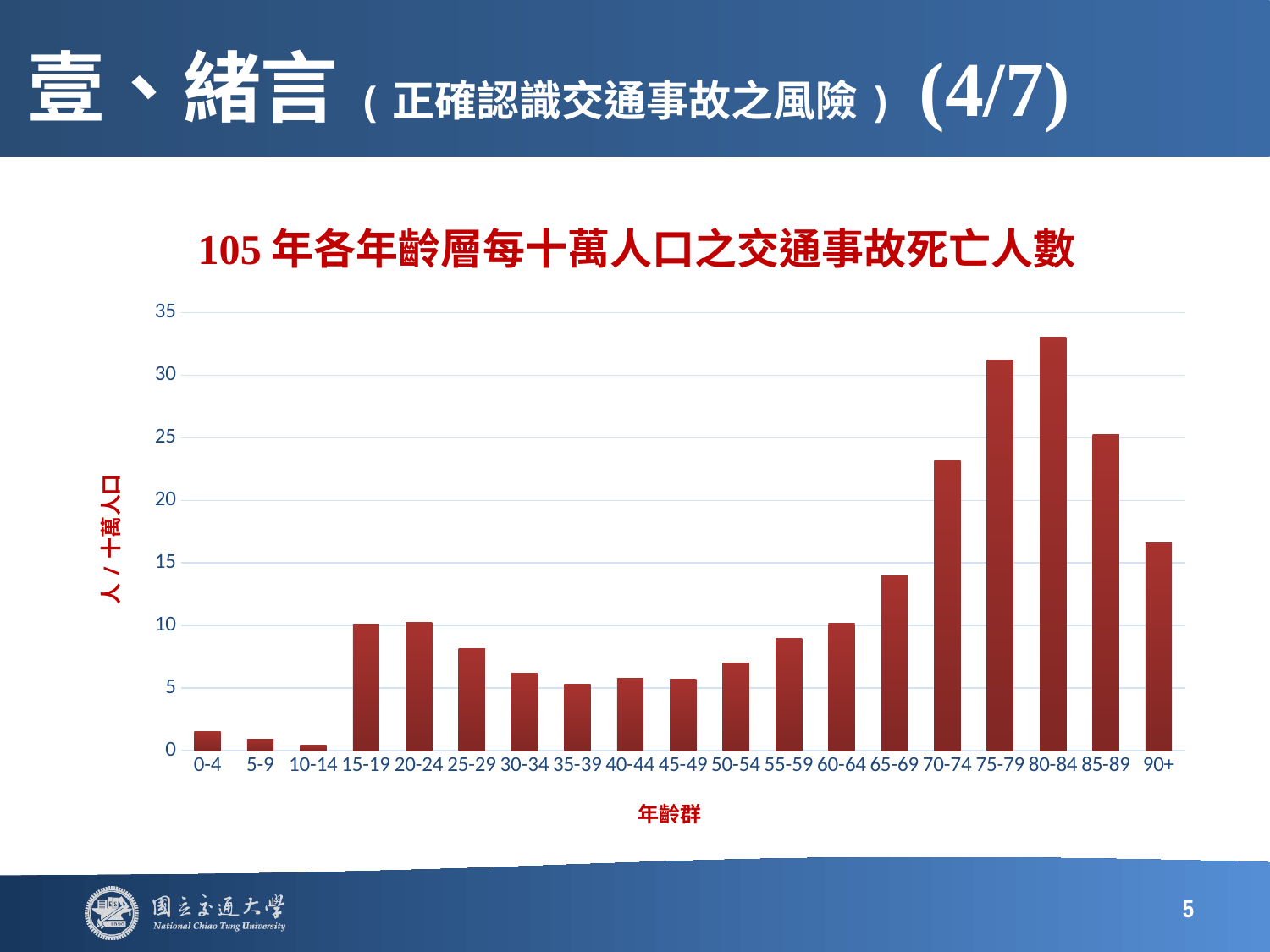
Is the value for the 90+ age group greater or less than 15? greater Which age group has a higher value, 70-74 or 90+? 70-74 Which age group has a higher value, 15-19 or 25-29? 15-19 Which age group has the lowest traffic accident death rate per 100,000 people? 10-14 Do the values rise or fall from the 35-39 age group to the 80-84 age group? rise Is the value for the 70-74 age group greater or less than 20? greater What is the title of the chart? 105 年各年齡層每十萬人口之交通事故死亡人數 Is the value for the 75-79 age group greater or less than 30? greater Which age group has the highest traffic accident death rate per 100,000 people? 80-84 What kind of chart is shown on the slide? bar chart How many age groups are shown on the x axis of the chart? 19